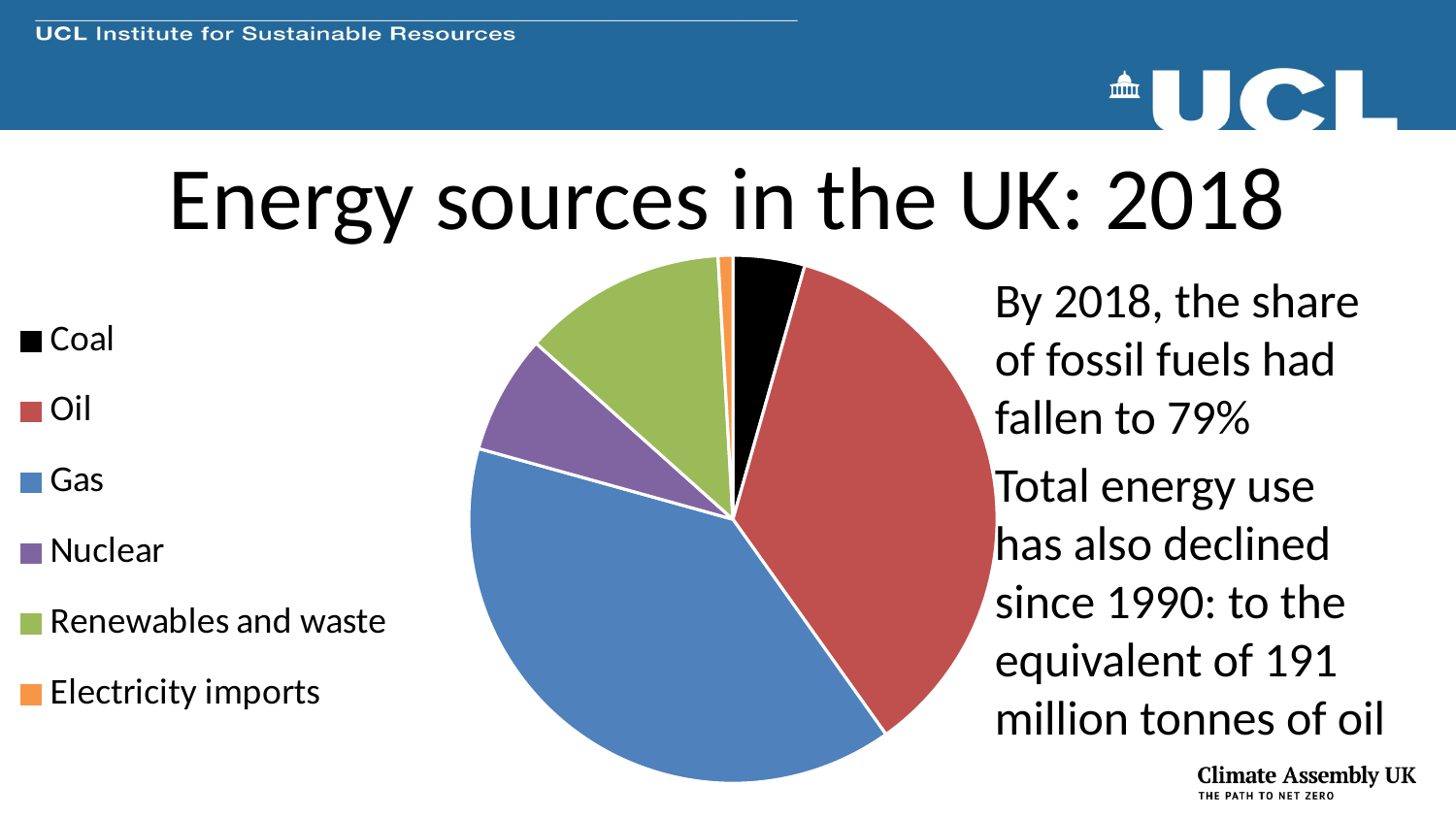
What colour is the Gas slice in the pie chart? blue Which slice is larger in the pie chart, Oil or Nuclear? Oil Which energy source has the largest slice of the pie chart? Gas Which slice is larger in the pie chart, Renewables and waste or Coal? Renewables and waste Which slice is larger in the pie chart, Renewables and waste or Electricity imports? Renewables and waste How many energy sources does the legend of the pie chart list? 6 Which energy source has the smallest slice of the pie chart? Electricity imports What kind of chart is shown on the slide? pie chart How many slices does the pie chart have? 6 What is the title of the chart on the slide? Energy sources in the UK: 2018